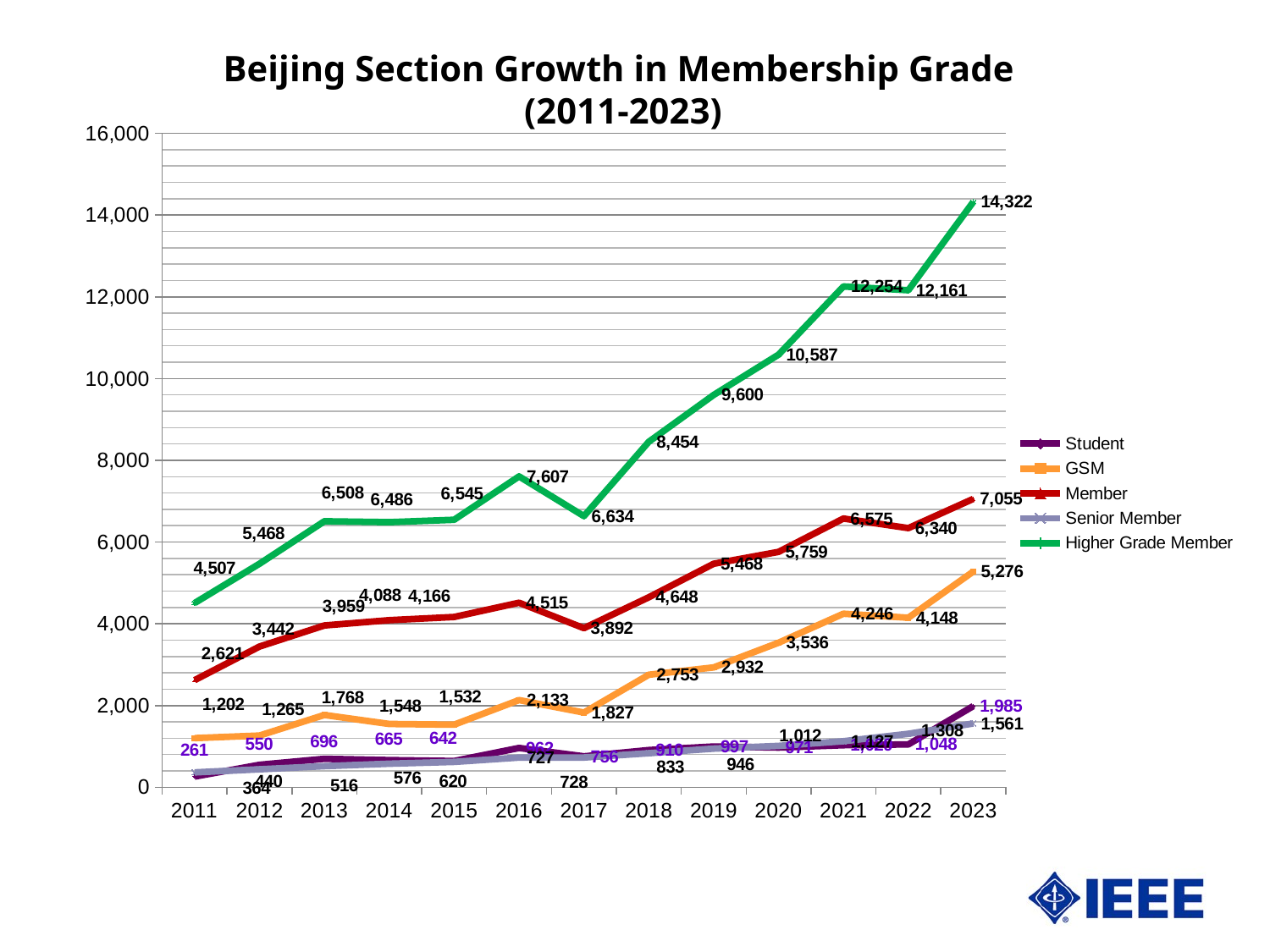
Is the value for Member in 2023 greater or less than 6,000? greater Does the GSM series generally rise or fall from 2011 to 2023? rise How many series does the legend list? 5 What is the value for Member in 2011? 2,621 What is the value for Higher Grade Member in 2023? 14,322 What is the difference between the Higher Grade Member values in 2023 and 2022? 2,161 In which year is the Member series at its lowest value? 2011 What is the value for GSM in 2020? 3,536 How many years are plotted on the x axis? 13 Which is larger, the Member value in 2021 or in 2022? 2021 What kind of chart is shown on the slide? line chart In which year does the Higher Grade Member series reach its highest value? 2023